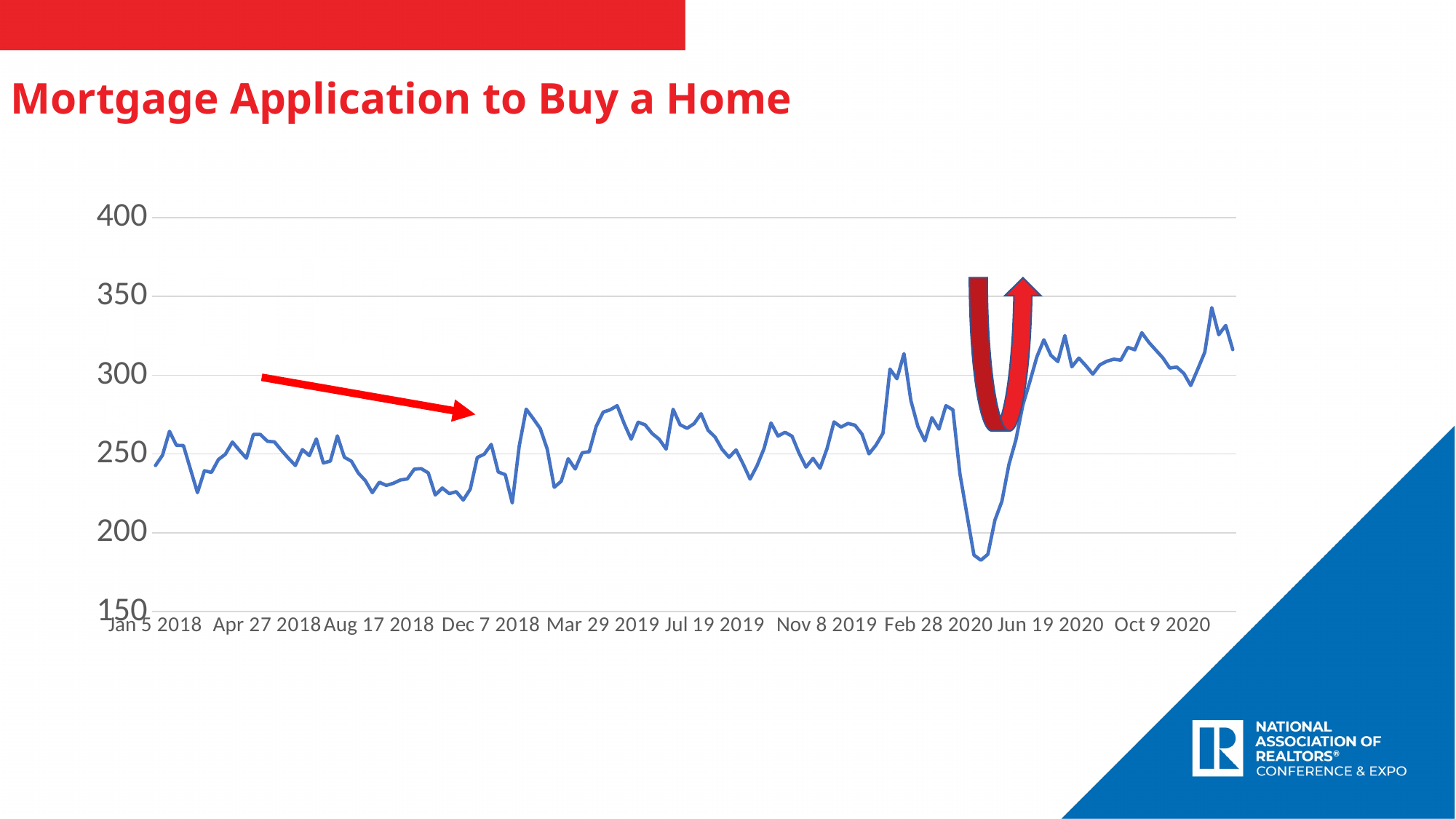
Is the value at Jun 19 2020 greater or less than 300? greater How many date labels are shown along the x axis? 10 How many lines (data series) are plotted on the chart? 1 Overall, does the line rise or fall from Jan 5 2018 to the end of the series in late 2020? rise Is the value at Jan 5 2018 greater or less than 300? less What kind of chart is shown on the slide? line chart What is the title of the chart on the slide? Mortgage Application to Buy a Home Is the value at Feb 28 2020 greater or less than 300? less Between which two x-axis labels does the line reach its lowest point? Feb 28 2020 and Jun 19 2020 What is the highest value shown on the y axis? 400